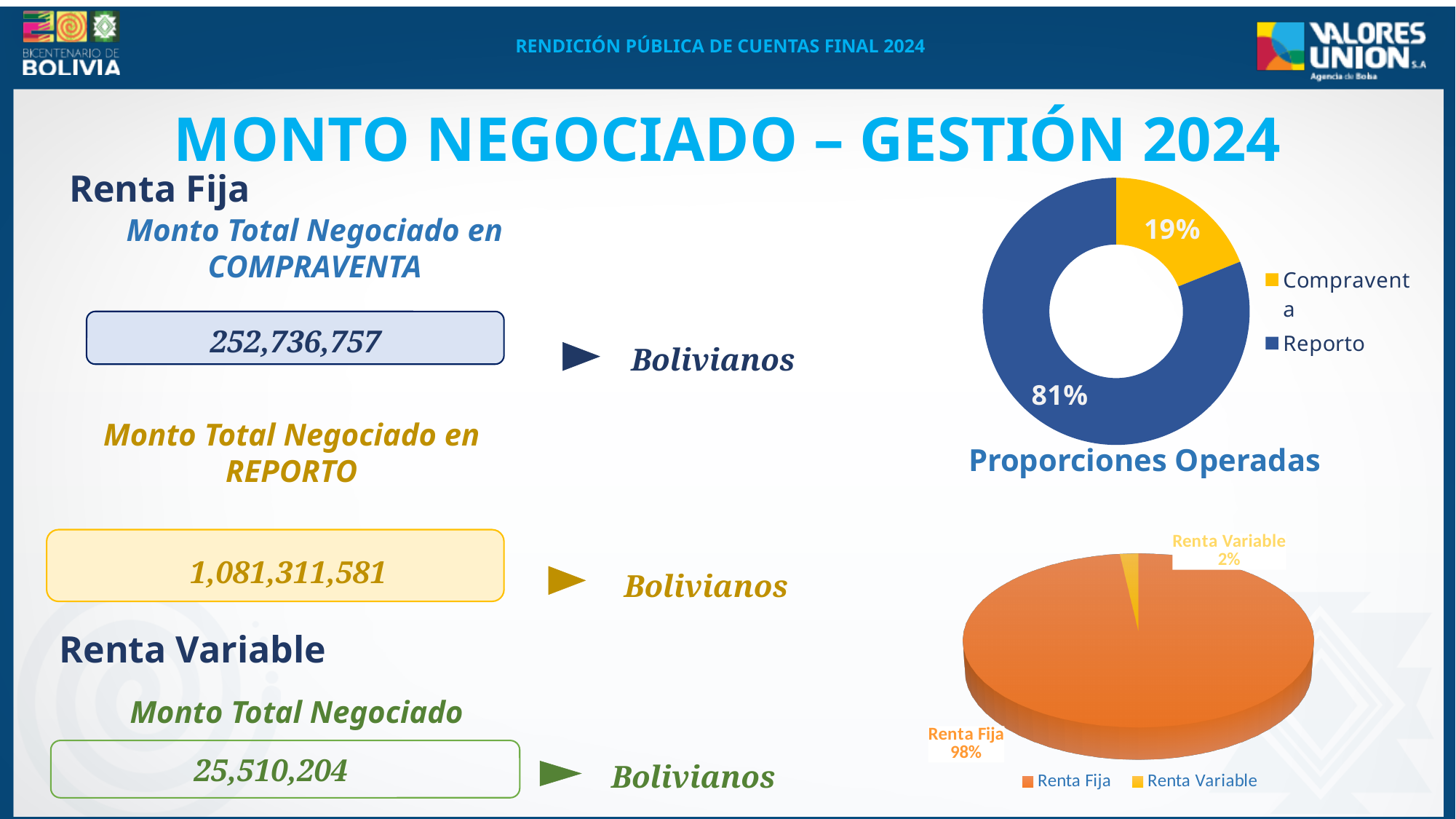
What kind of chart is shown at the bottom right of the slide? Pie chart What kind of chart is 'Proporciones Operadas'? Donut chart In the 'Proporciones Operadas' chart, what share does Reporto have? 81% In the 'Proporciones Operadas' chart, which category has the largest share? Reporto In the 'Proporciones Operadas' chart, what is the difference in percentage points between Reporto and Compraventa? 62 In the 'Proporciones Operadas' chart, which category has the smallest share? Compraventa In the pie chart at the bottom right, what share does Renta Variable have? 2% In the 'Proporciones Operadas' chart, what colour is the Reporto segment? Blue How many categories does the legend of the 'Proporciones Operadas' chart list? 2 In the pie chart at the bottom right, which category is larger, Renta Fija or Renta Variable? Renta Fija In the 'Proporciones Operadas' chart, what share does Compraventa have? 19% In the pie chart at the bottom right, what share does Renta Fija have? 98%